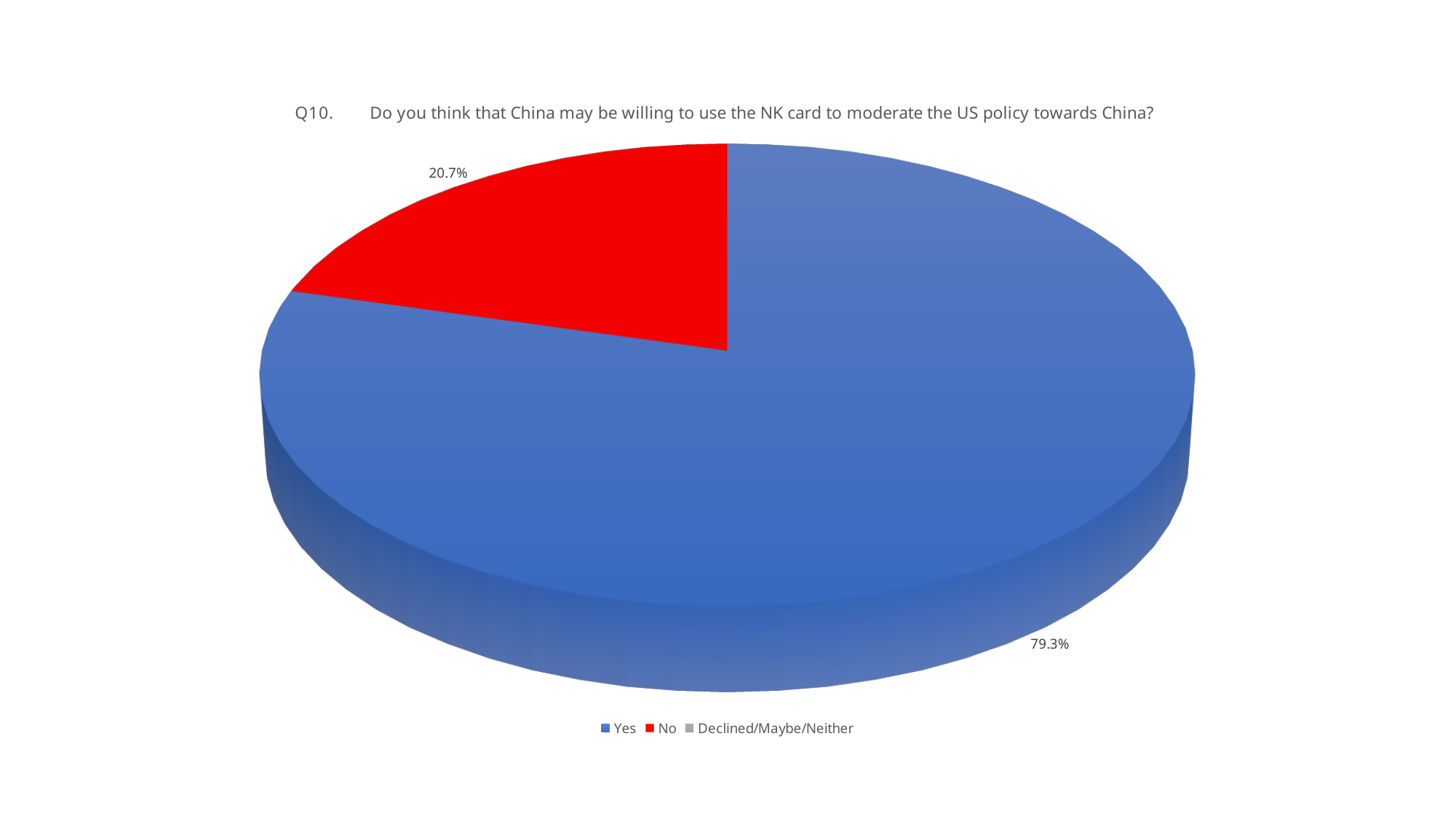
Which of the two labelled slices is smaller, Yes or No? No How many slices with data labels are visible in the pie? 2 Which response has the largest share of the pie? Yes Is the share for Yes larger or smaller than the share for No? larger What percentage of respondents answered No? 20.7% What is the difference in percentage points between the Yes and No shares? 58.6 How many entries does the legend list? 3 What kind of chart is shown on the slide? pie chart What is the third legend entry after Yes and No? Declined/Maybe/Neither What percentage of respondents answered Yes? 79.3% What colour is the slice representing No? red